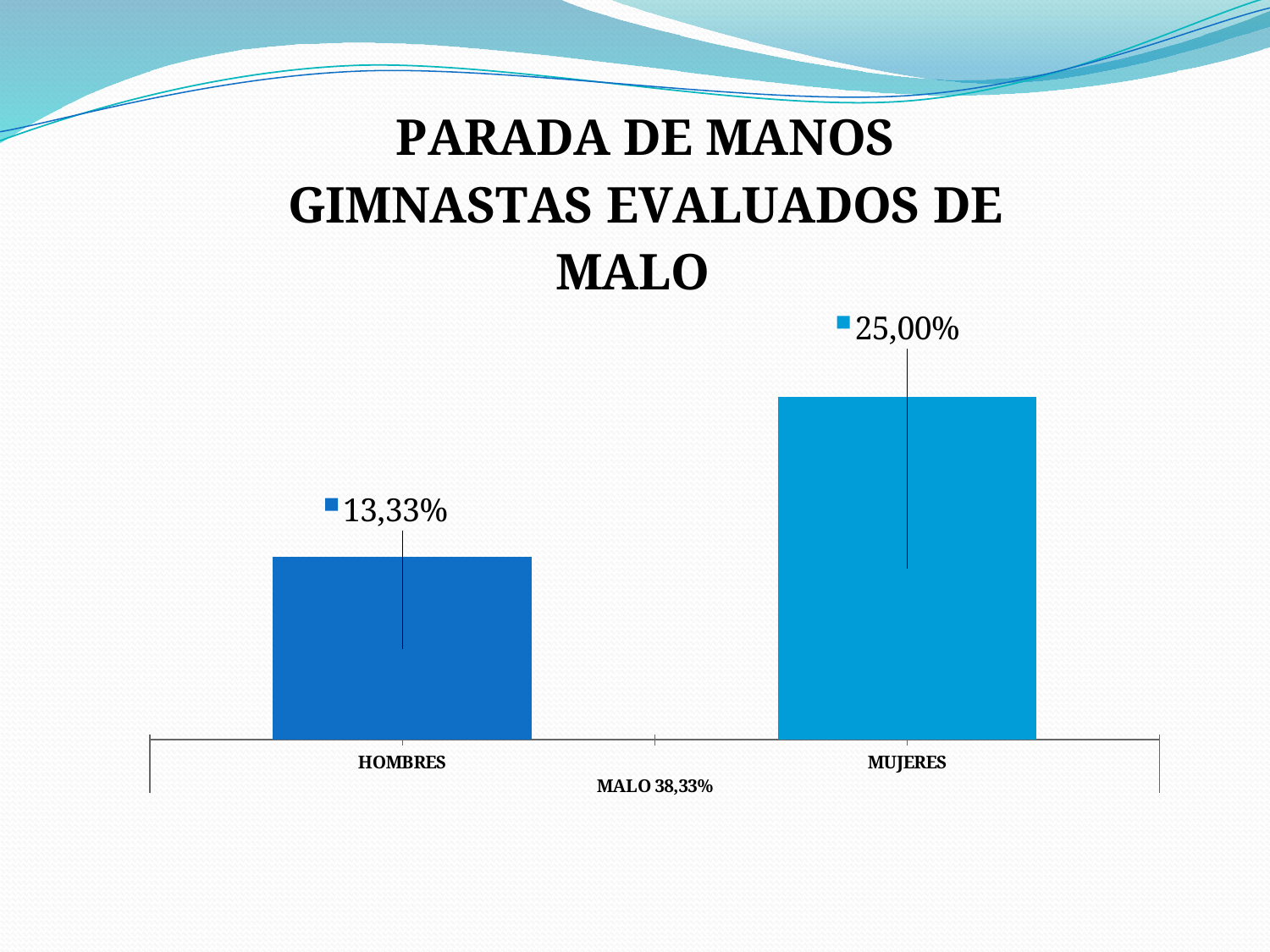
What kind of chart is shown on the slide? Bar chart What label appears below the x axis under the category names? MALO 38,33% Which category has the lowest value? HOMBRES Which is larger, the value for HOMBRES or the value for MUJERES? MUJERES What is the title of the chart? PARADA DE MANOS GIMNASTAS EVALUADOS DE MALO How many categories are shown on the x axis? 2 What is the value for HOMBRES? 13,33% What is the difference between the values for MUJERES and HOMBRES? 11,67% Which category has the highest value? MUJERES What is the value for MUJERES? 25,00% What is the total of the two values shown in the chart? 38,33%